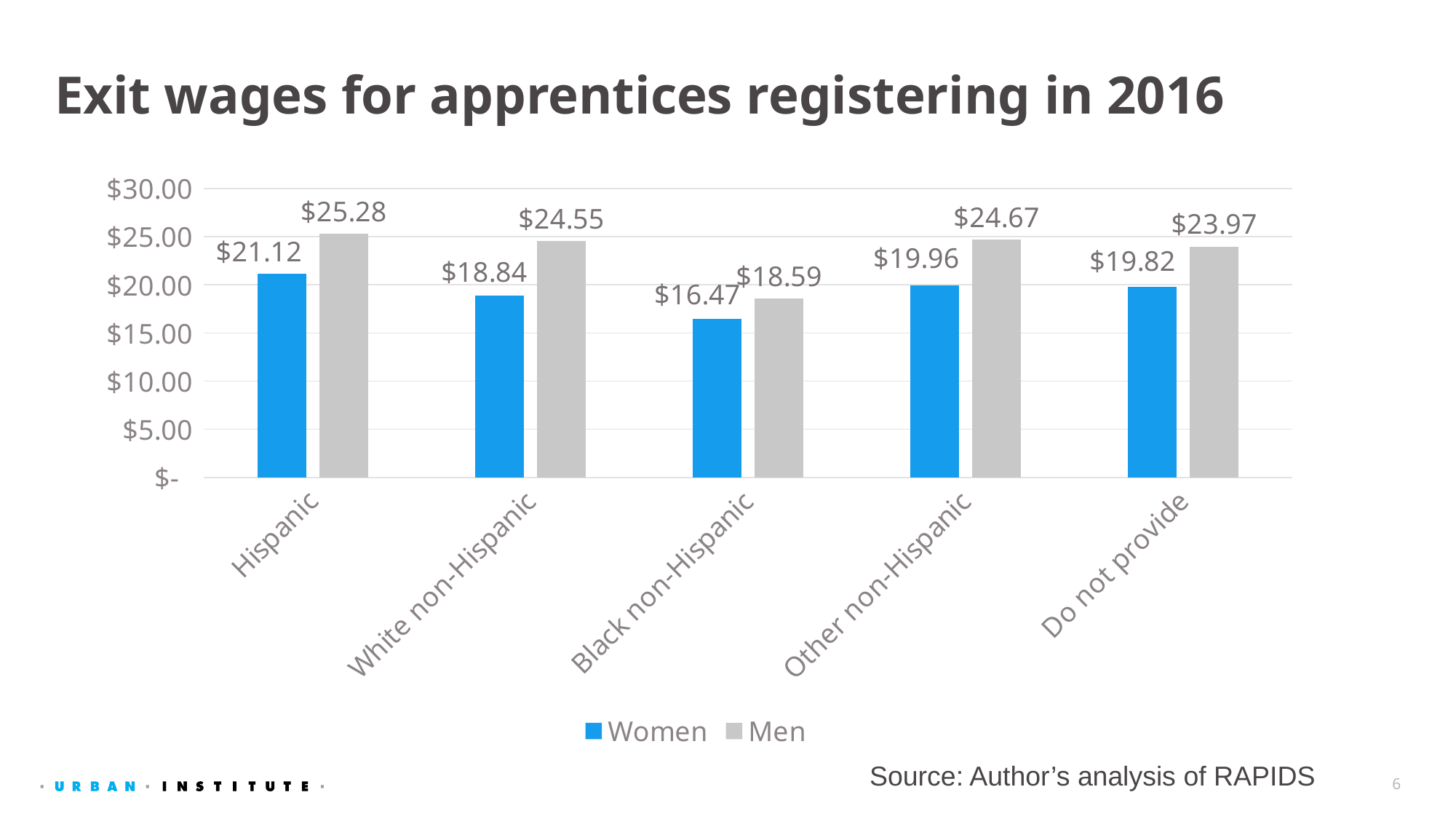
How many categories are shown on the x axis? 5 What is the exit wage for Hispanic women? $21.12 What kind of chart is shown on the slide? bar chart What is the difference between men's and women's exit wages for White non-Hispanic apprentices? $5.71 What is the exit wage for men in the 'Do not provide' category? $23.97 What is the exit wage for Black non-Hispanic men? $18.59 Is the exit wage for Black non-Hispanic women greater or less than $20.00? less What is the title of the chart? Exit wages for apprentices registering in 2016 Which category has the lowest exit wage for women? Black non-Hispanic Which category has the highest exit wage for men? Hispanic Which is larger: the exit wage for Other non-Hispanic women or for Hispanic women? Hispanic women How many series does the legend list? 2